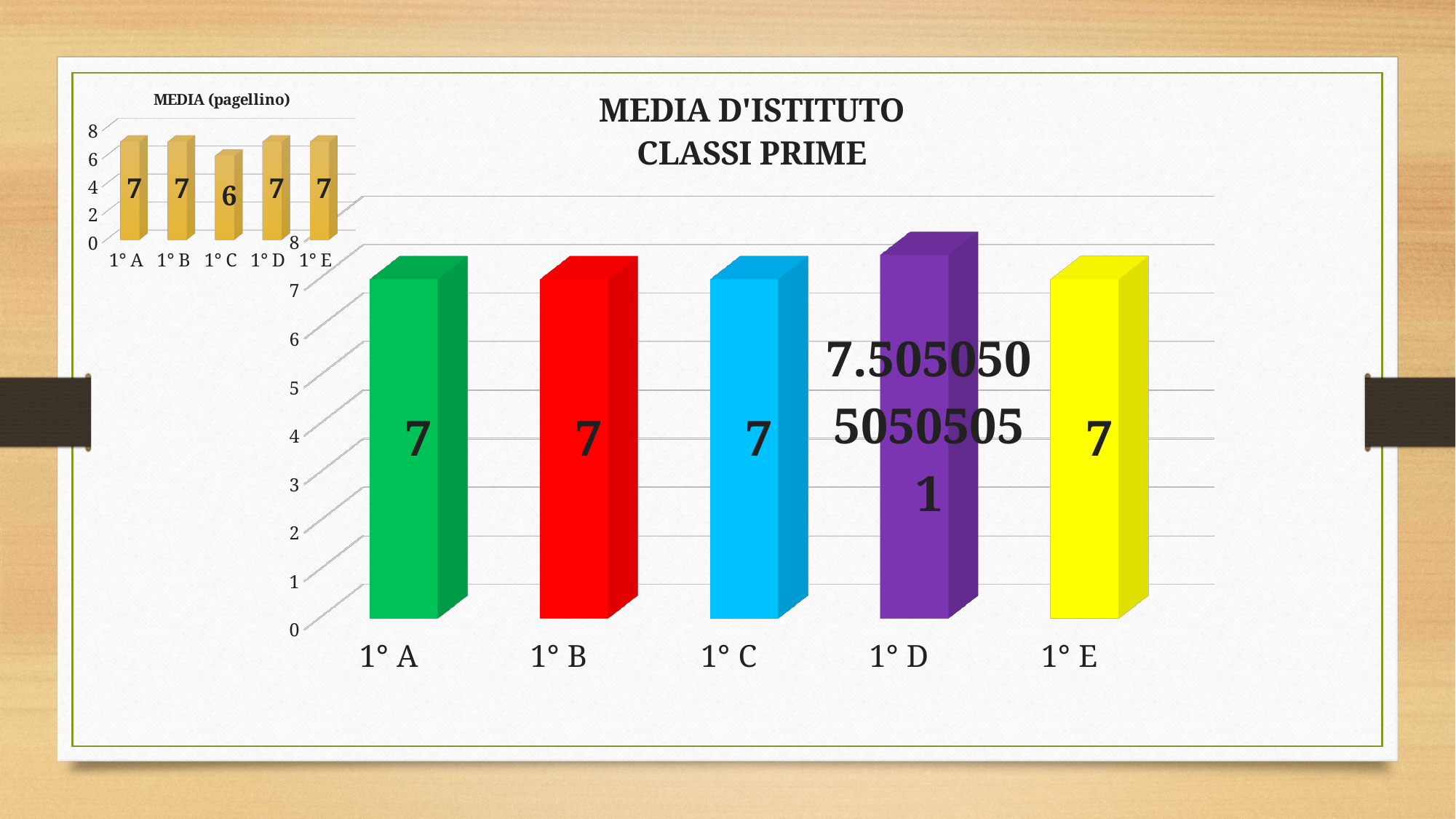
In the MEDIA (pagellino) chart, which is larger, the value for 1° B or the value for 1° C? 1° B In the MEDIA (pagellino) chart, how many bars are plotted? 5 In the MEDIA D'ISTITUTO CLASSI PRIME chart, is the value for 1° D greater or less than 7? greater What kind of chart is the MEDIA D'ISTITUTO CLASSI PRIME chart? bar chart In the MEDIA (pagellino) chart, which class has the lowest value? 1° C In the MEDIA D'ISTITUTO CLASSI PRIME chart, what is the value for 1° A? 7 In the MEDIA (pagellino) chart, what is the value for 1° C? 6 In the MEDIA D'ISTITUTO CLASSI PRIME chart, what colour is the bar for 1° D? purple In the MEDIA D'ISTITUTO CLASSI PRIME chart, how many classes are shown on the x axis? 5 In the MEDIA D'ISTITUTO CLASSI PRIME chart, what is the value shown for 1° D? 7.50505050505051 In the MEDIA D'ISTITUTO CLASSI PRIME chart, which class has the highest value? 1° D In the MEDIA (pagellino) chart, what is the difference between the values for 1° A and 1° C? 1